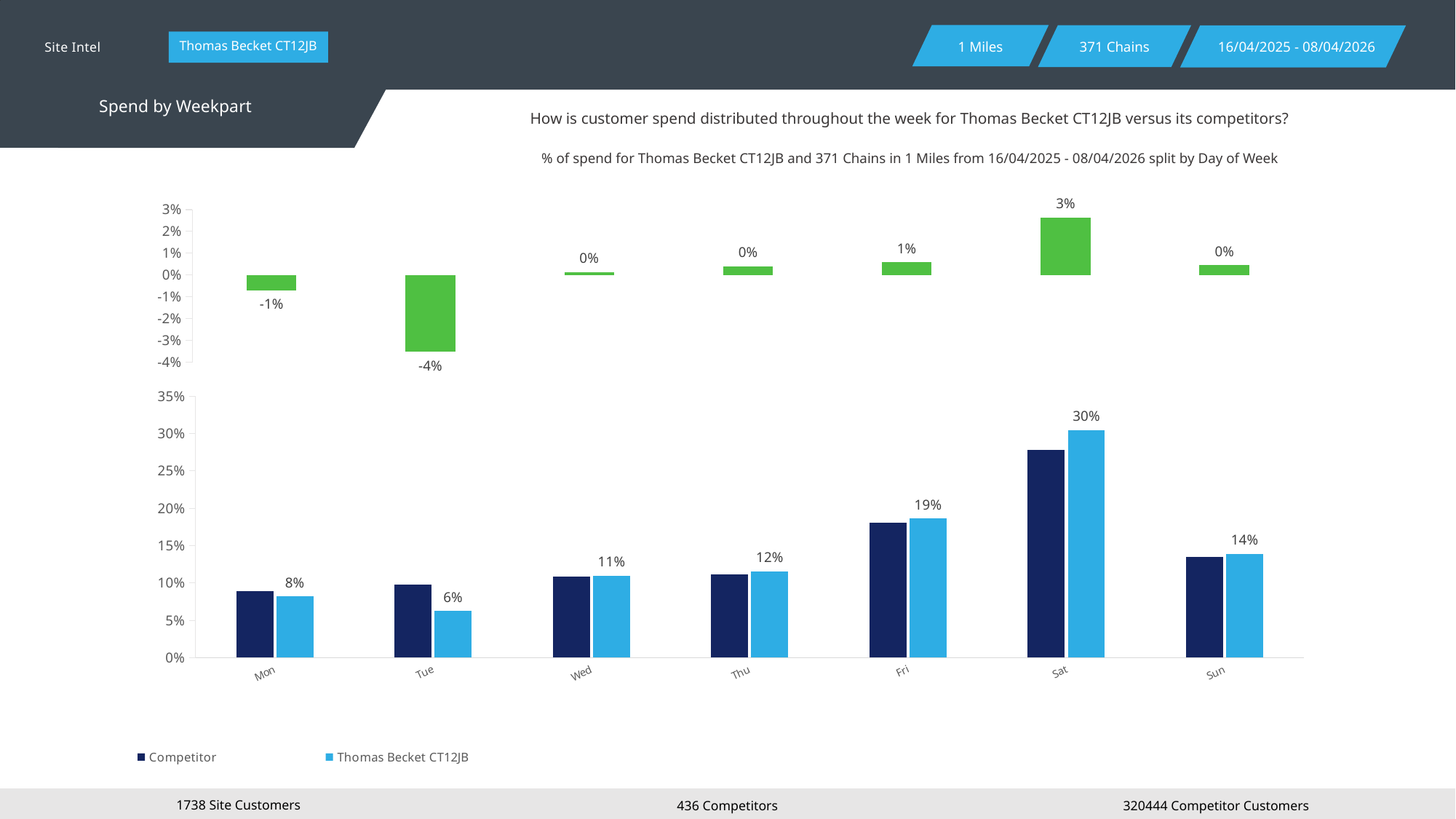
In the top chart, which day has the lowest value? Tue In the bottom chart, on which day is the Thomas Becket CT12JB value highest? Sat What kind of chart is the bottom chart? Bar chart How many days of the week are shown on the x axis of the bottom chart? 7 In the bottom chart, on Tue, which is larger: the Competitor bar or the Thomas Becket CT12JB bar? Competitor How many series does the legend of the bottom chart list? 2 In the bottom chart, is the Competitor value for Sat greater or less than 25%? greater In the bottom chart, what is the value for Thomas Becket CT12JB on Sat? 30% In the top chart, which day has the highest value? Sat In the top chart, what is the value shown for Tue? -4% In the bottom chart, what is the difference between the Thomas Becket CT12JB values for Sat and Tue? 24% In the bottom chart, on which day is the Thomas Becket CT12JB value lowest? Tue